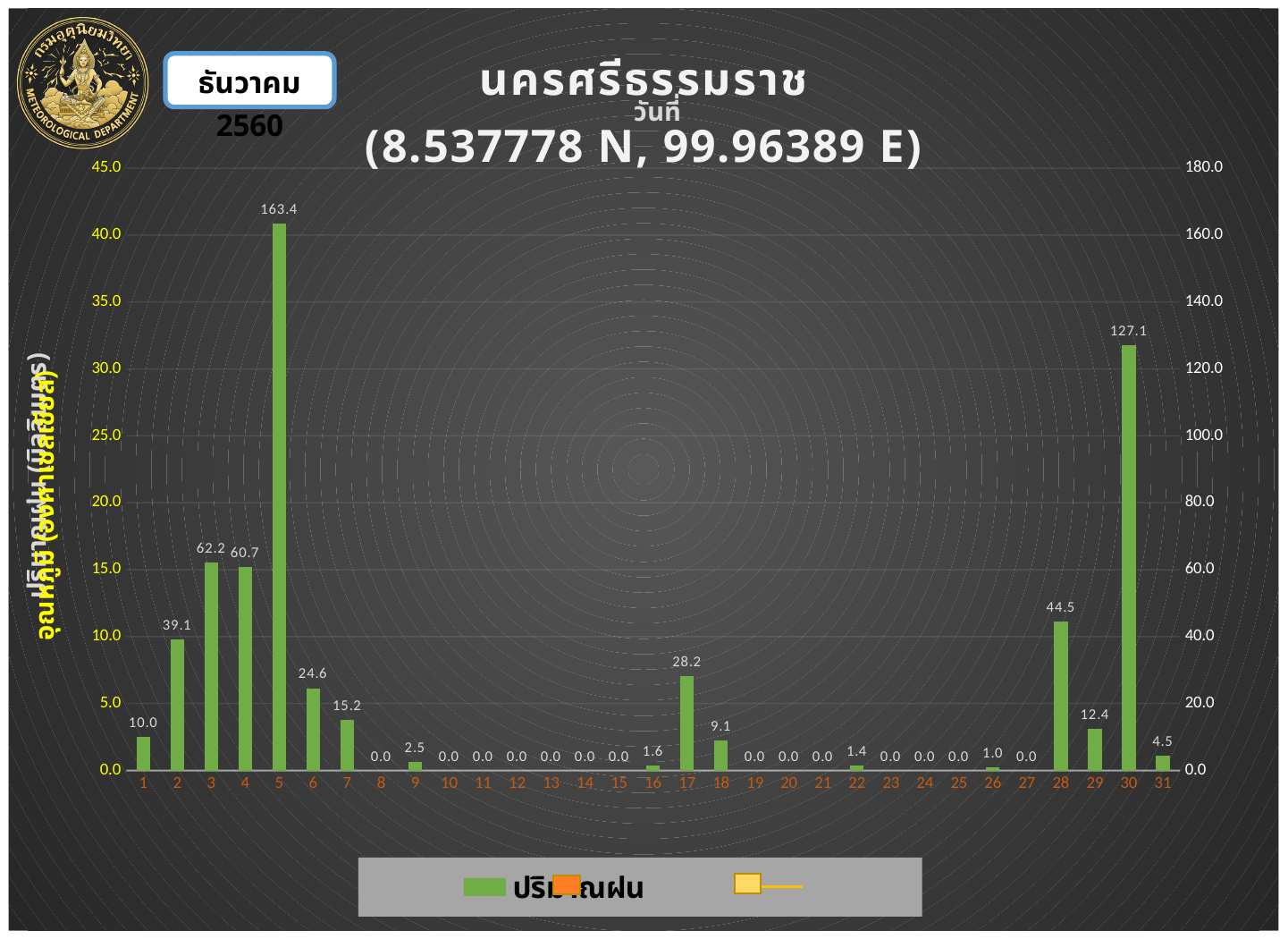
What is the rainfall value shown for day 28? 44.5 Which day has the highest rainfall value? 5 What is the difference between the rainfall values for day 28 and day 29? 32.1 Which has the larger rainfall value, day 3 or day 4? day 3 Do the rainfall values rise or fall from day 1 to day 5? rise What is the difference between the rainfall values for day 5 and day 30? 36.3 What is the rainfall value shown for day 5? 163.4 Which has the larger rainfall value, day 2 or day 17? day 2 What is the rainfall value shown for day 30? 127.1 What is the rainfall value shown for day 17? 28.2 How many days are shown on the x axis? 31 What kind of chart is shown on the slide? bar chart